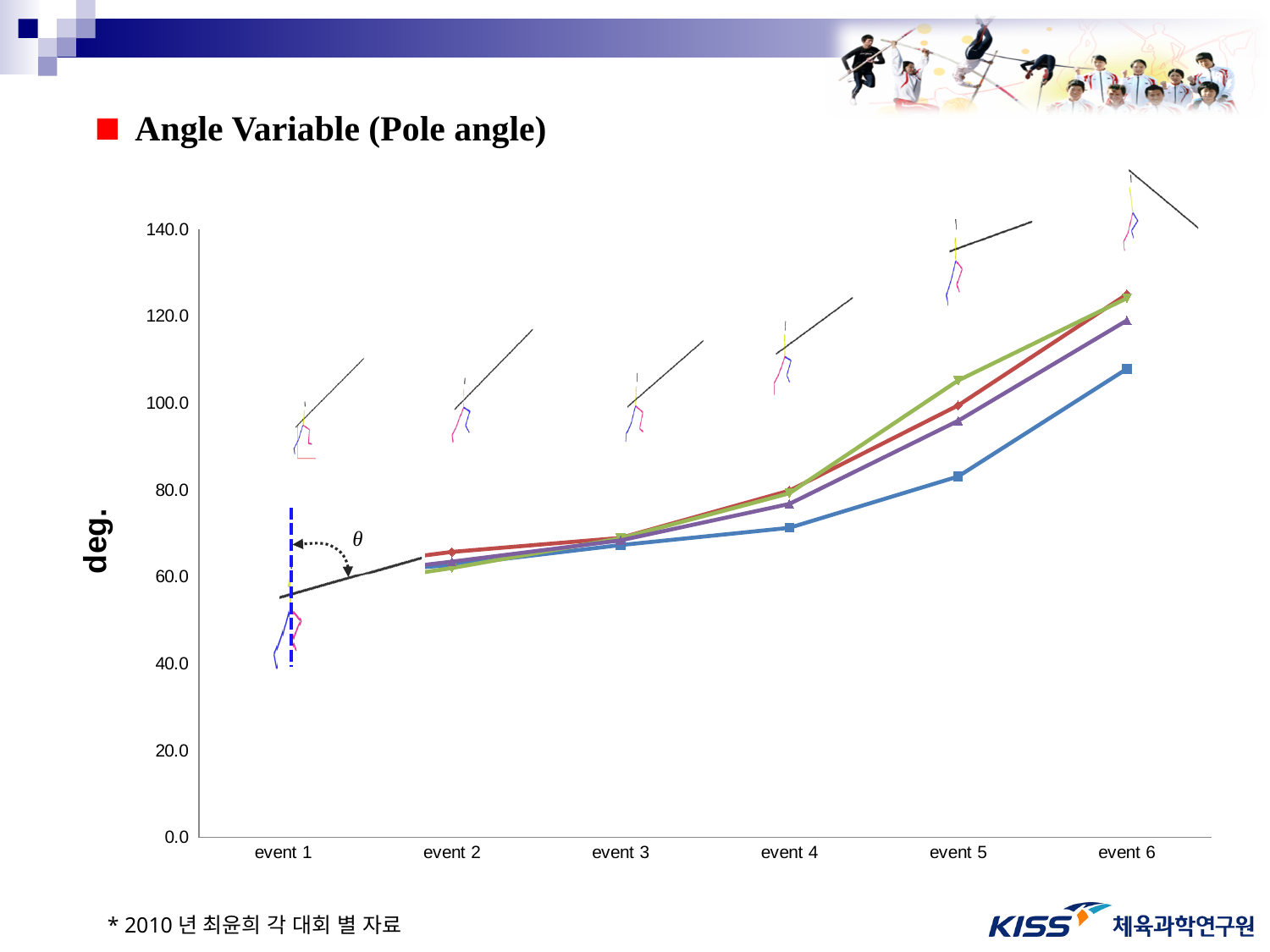
What is the label on the y axis of the chart? deg. Which line has the lowest value at event 6? the blue line Do the plotted values rise or fall from event 1 to event 6? rise Is the value of the green line at event 5 greater or less than 100? greater Is the value of the blue line at event 4 greater or less than 80? less Is the value of the blue line at event 6 greater or less than 100? greater Which line has the highest value at event 5? the green line What kind of chart is shown on the slide? line chart How many events are shown along the x axis of the chart? 6 At event 6, which is larger: the value of the blue line or the value of the green line? the green line